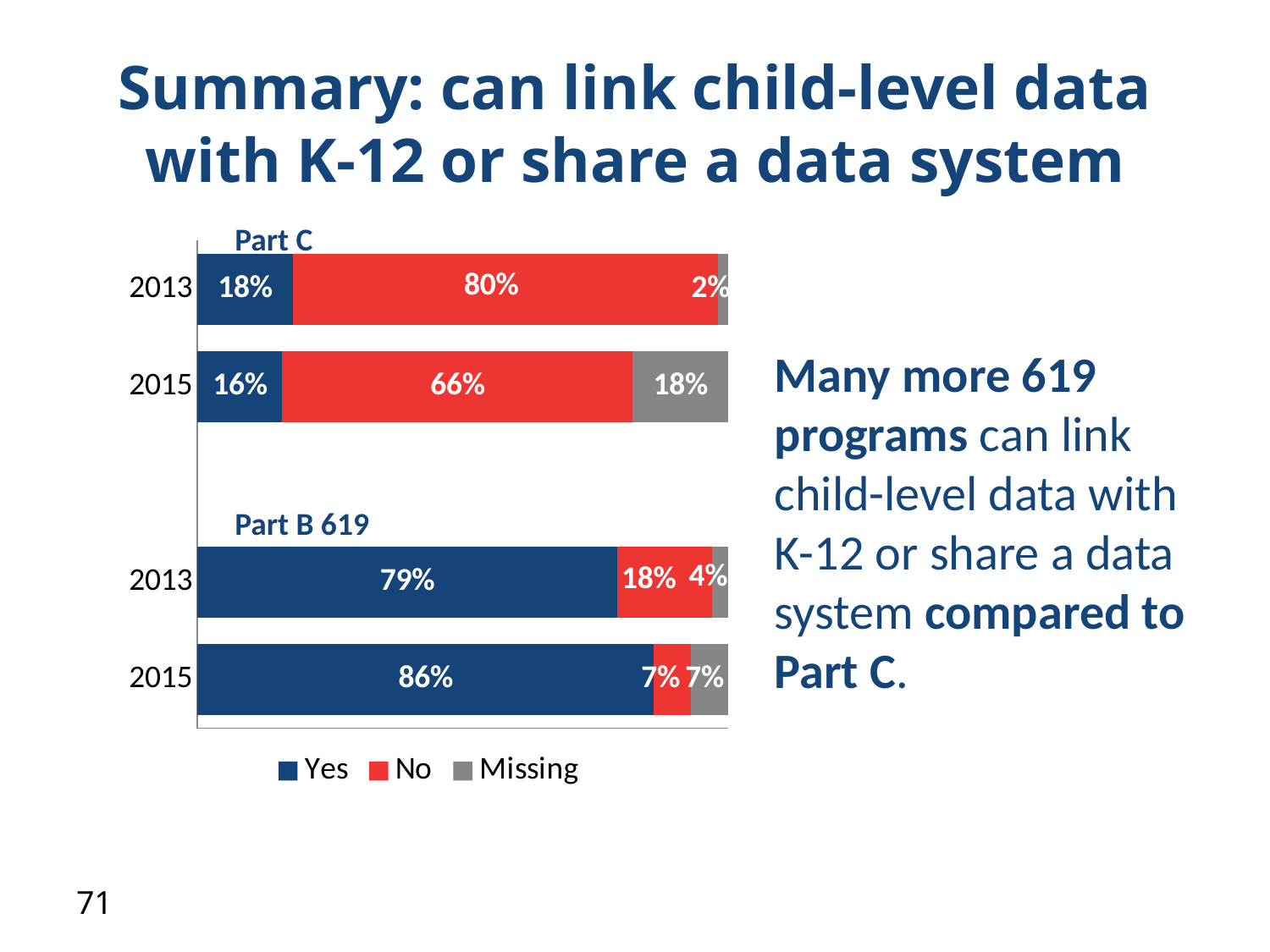
Which is larger: the 'No' value for Part C in 2013 or the 'No' value for Part B 619 in 2013? Part C in 2013 What is the 'Yes' value for Part C in 2013? 18% What is the 'No' value for Part C in 2015? 66% Which bar has the lowest 'Missing' value? Part C, 2013 What is the difference between the 'Yes' values for Part B 619 in 2015 and 2013? 7% What is the 'Missing' value for Part B 619 in 2013? 4% Which legend entry is shown in red? No What kind of chart is shown on the slide? Stacked bar chart How many series does the legend list? 3 What is the 'Yes' value for Part B 619 in 2015? 86% How many bars are plotted in the chart? 4 Which bar has the highest 'Yes' value? Part B 619, 2015